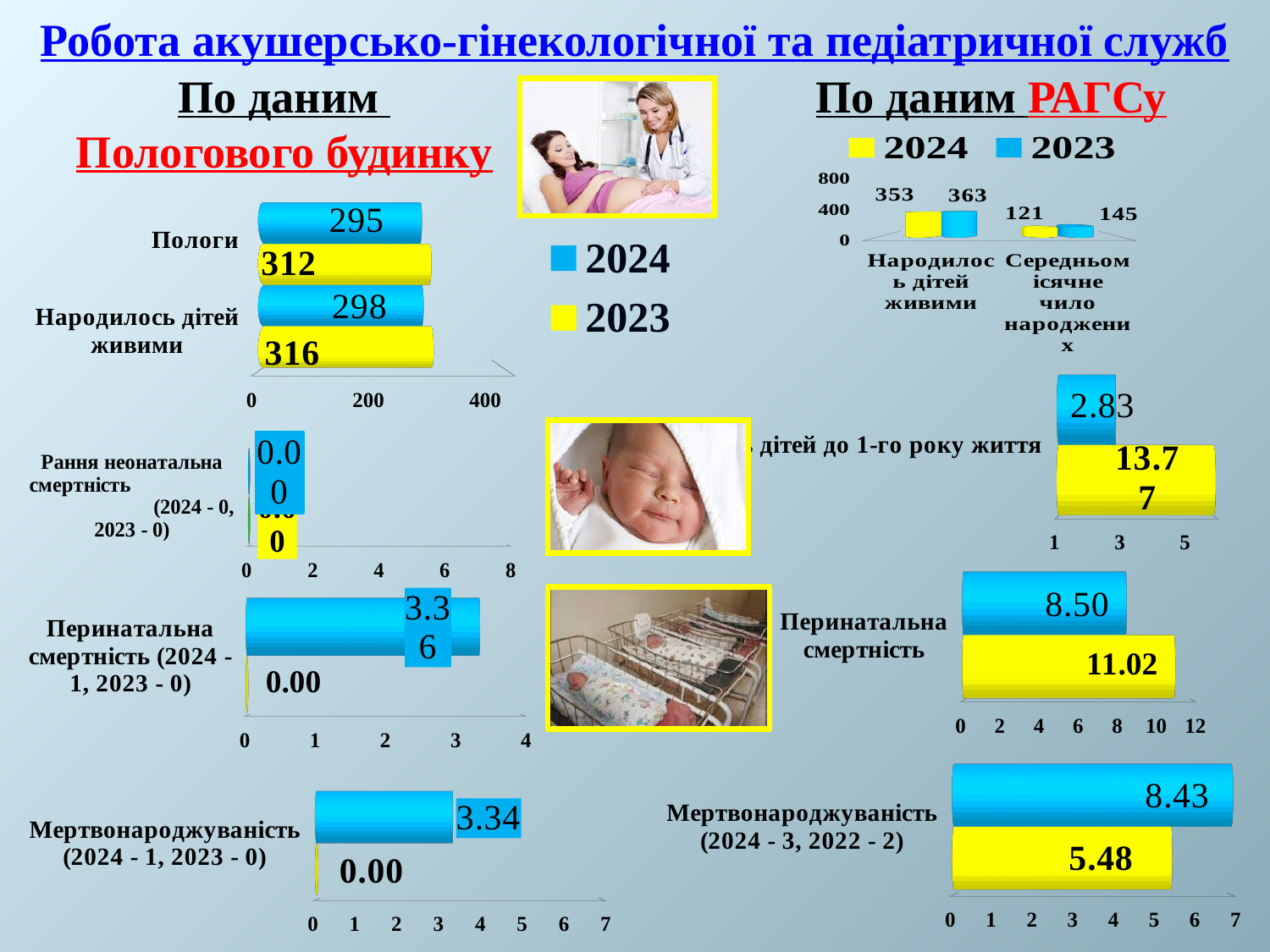
In the 'По даним РАГСу' chart, what is the 2023 value for 'Народилось дітей живими'? 363 In the 'По даним РАГСу' chart, how many series does the legend list? 2 In the 'По даним Пологового будинку' chart, what is the difference between the yellow and blue bars for 'Пологи'? 17 In the 'По даним Пологового будинку' chart, what is the value of the blue bar for 'Народилось дітей живими'? 298 In the 'По даним РАГСу' chart, what is the difference between the 2023 and 2024 values for 'Середньомісячне число народжених'? 24 In the 'Перинатальна смертність' chart on the left side of the slide, what is the value of the blue bar? 3.36 In the 'Мертвонароджуваність' chart on the right side of the slide, what is the value of the yellow bar? 5.48 In the 'По даним РАГСу' chart, what is the 2024 value for 'Середньомісячне число народжених'? 121 What kind of chart is the 'По даним Пологового будинку' chart? bar chart In the 'По даним Пологового будинку' chart, what is the value of the yellow bar for 'Пологи'? 312 In the 'По даним Пологового будинку' chart, which bar is larger for 'Народилось дітей живими', the blue one or the yellow one? the yellow one In the 'Перинатальна смертність' chart on the right side of the slide, which bar is larger, the blue one or the yellow one? the yellow one